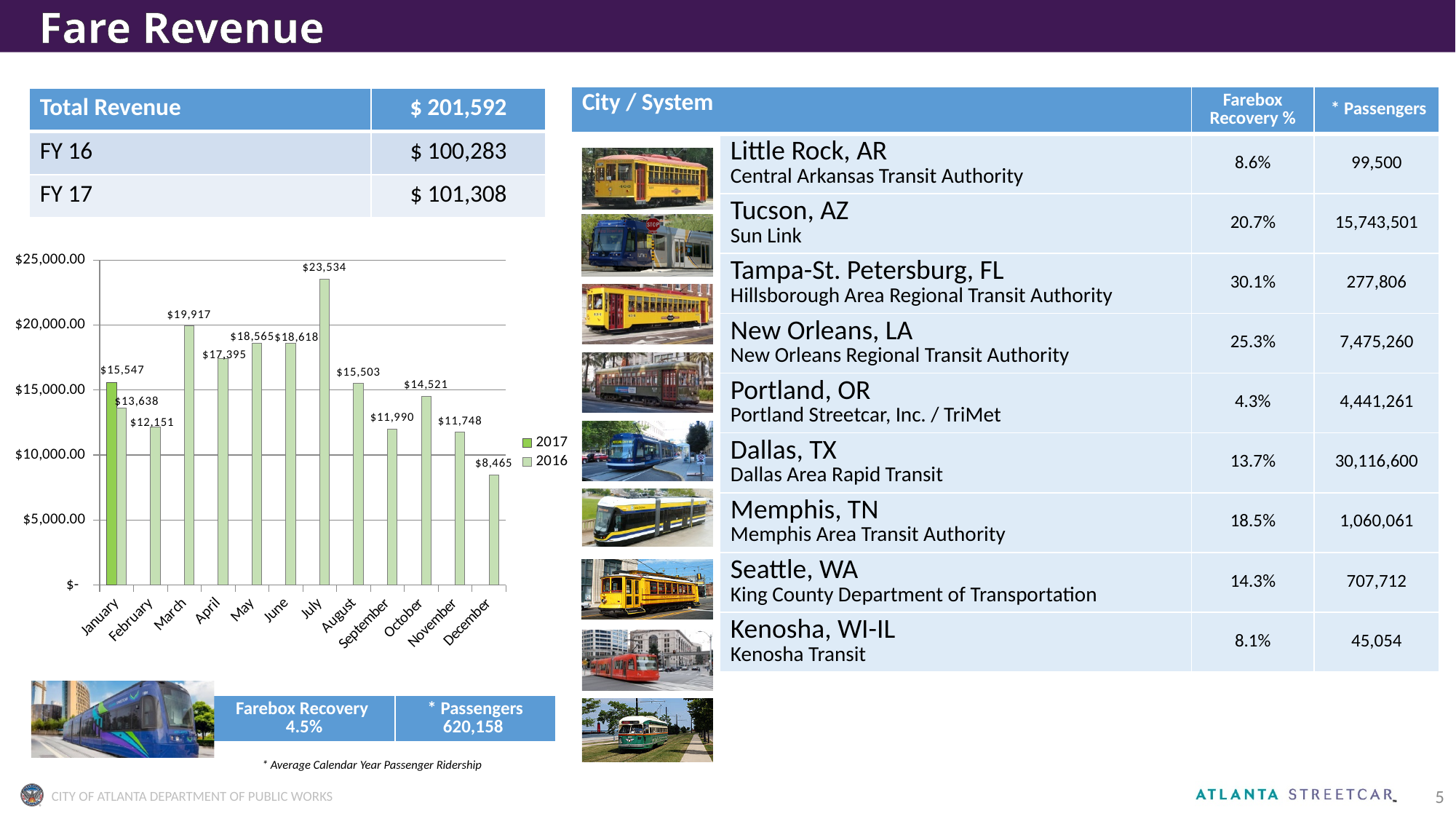
How many series does the legend list? 2 What kind of chart is shown on the slide? bar chart Do the 2016 values rise or fall from October to December? fall Which month has the lowest 2016 value? December What is the 2017 value for January? $15,547 What is the difference between the January 2017 value and the January 2016 value? $1,909 Which is larger, the 2016 value for March or the 2016 value for April? March What is the 2016 value for December? $8,465 How many months are shown on the x axis? 12 Is the 2016 value for October greater or less than $15,000.00? less Which month has the highest 2016 value? July What is the 2016 value for July? $23,534